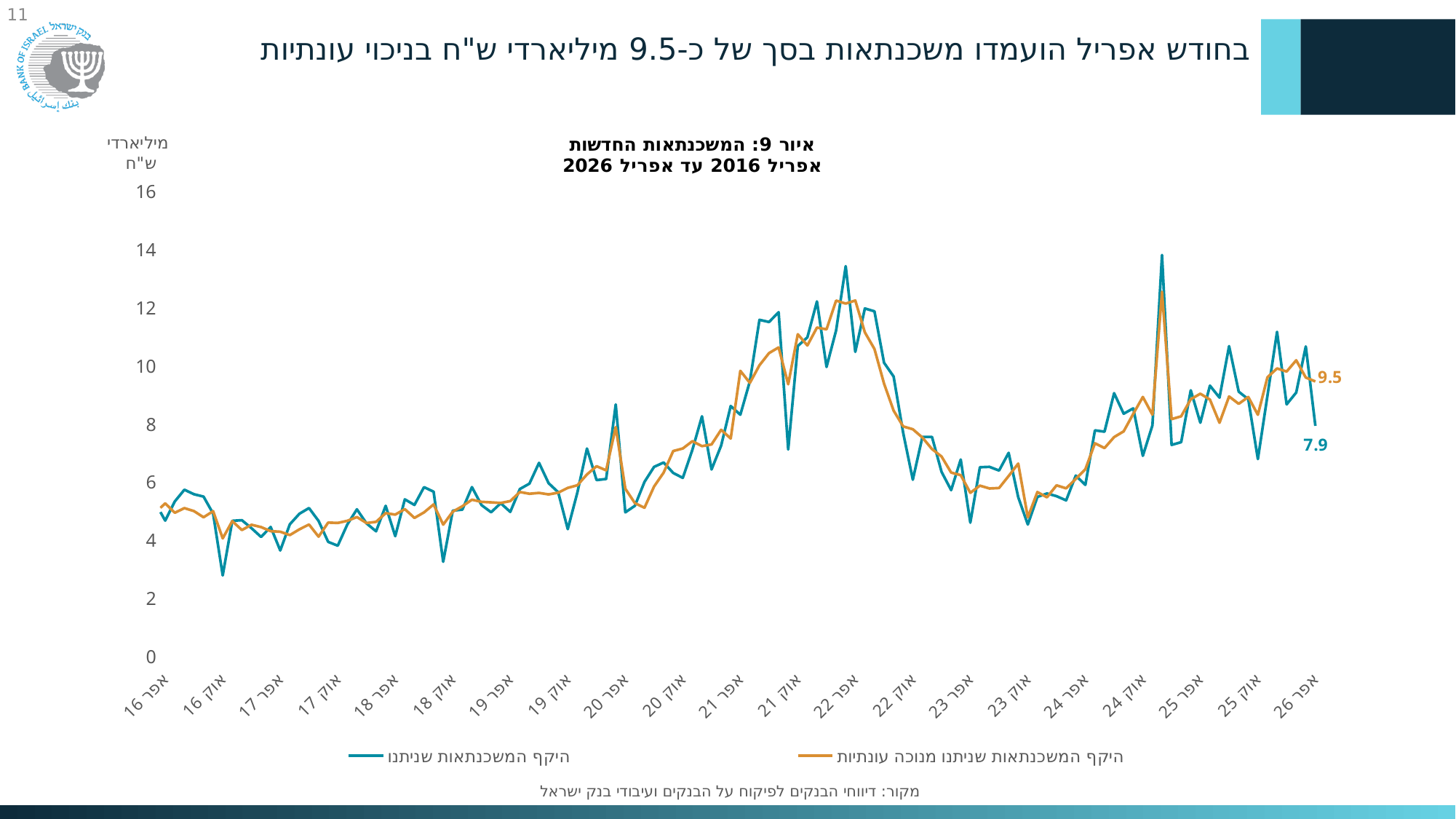
How many series does the legend list? 2 Between אפר 22 and אפר 23, do the values of the seasonally adjusted series rise or fall? fall What is the difference between the two labelled values at אפר 26 (9.5 and 7.9)? 1.6 What unit is shown on the y axis of the chart? מיליארדי ש"ח What kind of chart is shown on the slide? line chart At אפר 26, which series has the larger labelled value: the seasonally adjusted series or the unadjusted series? the seasonally adjusted series (9.5) What is the last labelled value of the seasonally adjusted series (היקף המשכנתאות שניתנו מנוכה עונתיות) at אפר 26? 9.5 What is the title of the chart? איור 9: המשכנתאות החדשות אפריל 2016 עד אפריל 2026 Is the value of the seasonally adjusted series at אפר 23 greater or less than 8? less Is the value of the unadjusted series at אוק 16 greater or less than 4? less What is the last labelled value of the unadjusted series (היקף המשכנתאות שניתנו) at אפר 26? 7.9 Is the peak of the unadjusted series (היקף המשכנתאות שניתנו) around אפר 22 greater or less than 12? greater